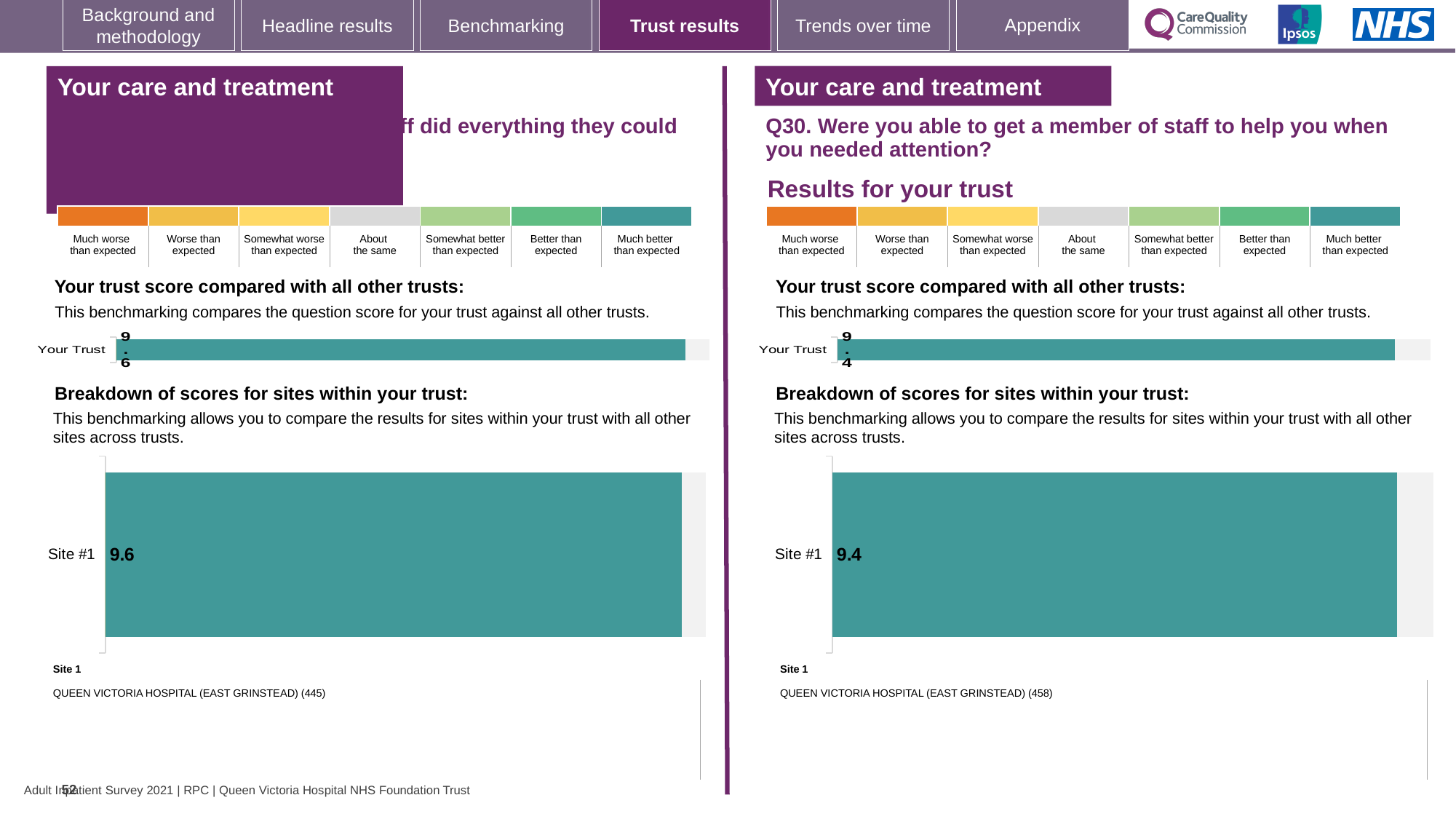
What type of chart is used to show the Site #1 score in the right-hand breakdown chart (Q30)? Bar chart Which is larger: the Site #1 score in the left-hand breakdown chart or the Site #1 score in the right-hand breakdown chart (Q30)? Left-hand chart (9.6) In the left-hand 'Breakdown of scores for sites within your trust' chart, what is the value for Site #1? 9.6 What is the difference between the Your Trust score on the left-hand side (9.6) and the Your Trust score on the right-hand side (9.4)? 0.2 Which site name is listed under Site 1 in the right-hand breakdown (Q30)? QUEEN VICTORIA HOSPITAL (EAST GRINSTEAD) (458) What colour is the bar for Site #1 in the left-hand breakdown chart? Teal How many sites are shown in the right-hand 'Breakdown of scores for sites within your trust' chart (Q30)? 1 On the left-hand side of the slide, what is the score shown for Your Trust in the trust score chart? 9.6 How many sites are shown in the left-hand 'Breakdown of scores for sites within your trust' chart? 1 In the right-hand 'Breakdown of scores for sites within your trust' chart (Q30), what is the value for Site #1? 9.4 Is the Your Trust score in the right-hand trust score chart (Q30) greater or less than the Your Trust score in the left-hand chart? less On the right-hand side of the slide (Q30), what is the score shown for Your Trust in the trust score chart? 9.4